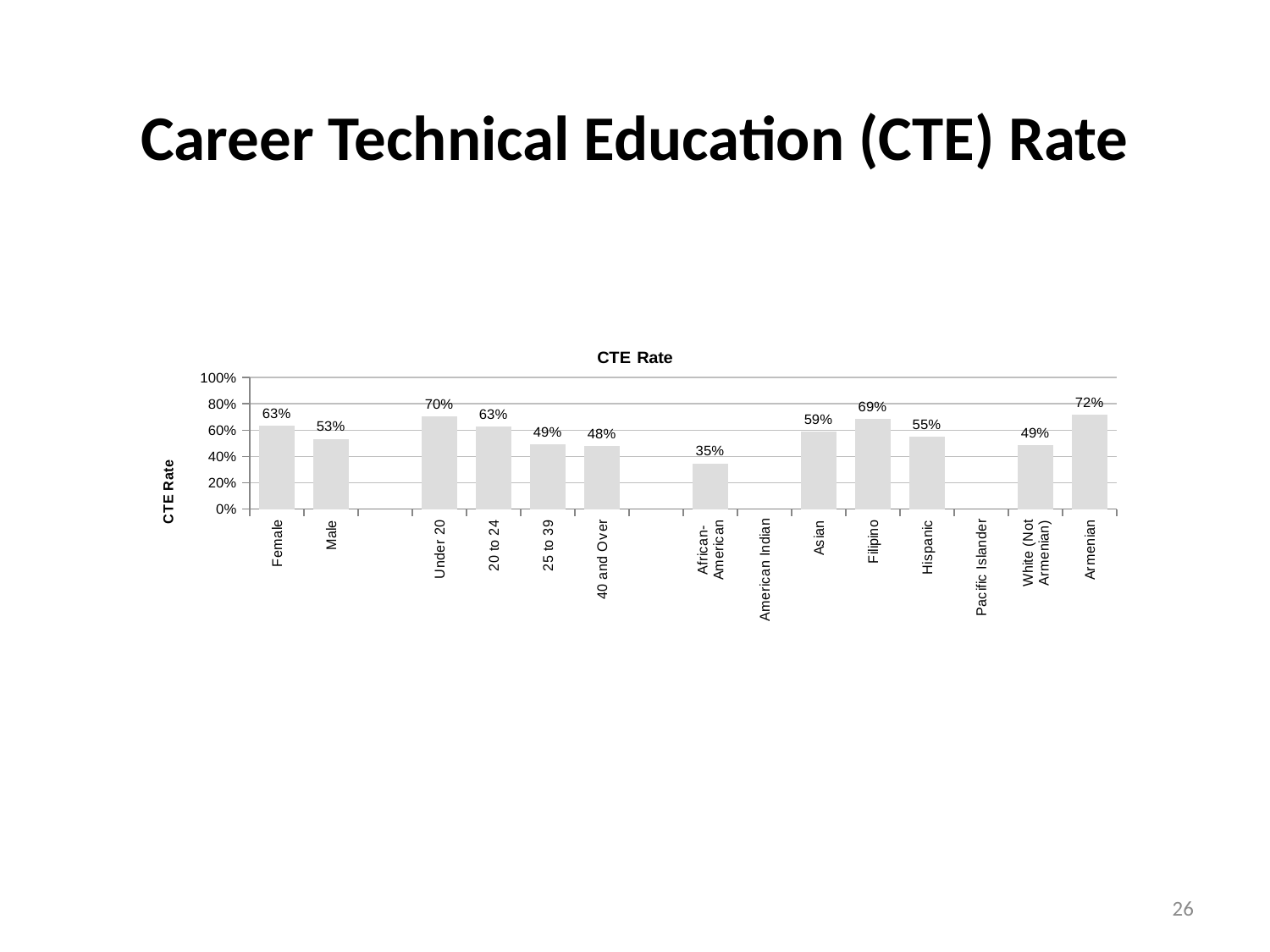
Which category with a plotted bar has the lowest CTE rate? African-American What is the difference between the CTE rate for Under 20 and for 40 and Over? 22 percentage points What is the CTE rate for African-American? 35% Is the CTE rate for Male greater or less than 60%? less What is the CTE rate for Hispanic? 55% What is the CTE rate for Under 20? 70% What is the CTE rate for Female? 63% Which category has the highest CTE rate? Armenian Which has a higher CTE rate, Filipino or Asian? Filipino What kind of chart is shown on the slide? bar chart How many category labels are shown on the x axis? 14 What is the title of the chart? CTE Rate